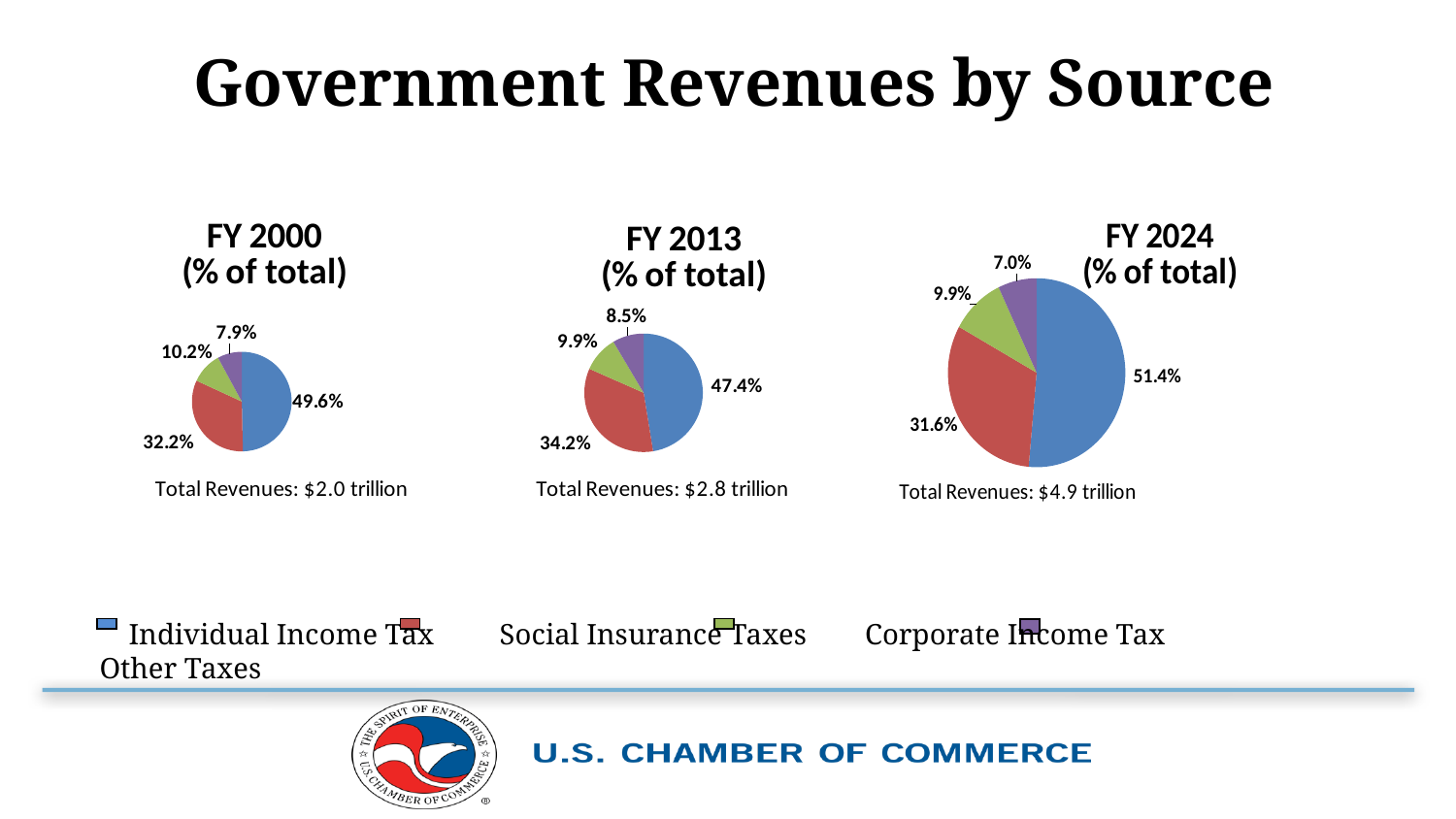
In the FY 2013 pie chart, what share of total revenues comes from Social Insurance Taxes? 34.2% How many revenue sources does the legend list? 4 What total revenue figure is shown beneath the FY 2024 pie chart? $4.9 trillion In the FY 2024 pie chart, which revenue source has the largest share? Individual Income Tax What type of chart is used to show the FY 2000 revenues by source? Pie chart In the FY 2000 pie chart, how many percentage points larger is the Individual Income Tax share than the Social Insurance Taxes share? 17.4 percentage points In the FY 2000 pie chart, what share of total revenues comes from Individual Income Tax? 49.6% In the FY 2024 pie chart, what share of total revenues comes from Other Taxes? 7.0% In the FY 2013 pie chart, which revenue source has the smallest share? Other Taxes What total revenue figure is shown beneath the FY 2000 pie chart? $2.0 trillion Is the Individual Income Tax share larger in the FY 2013 chart or the FY 2024 chart? FY 2024